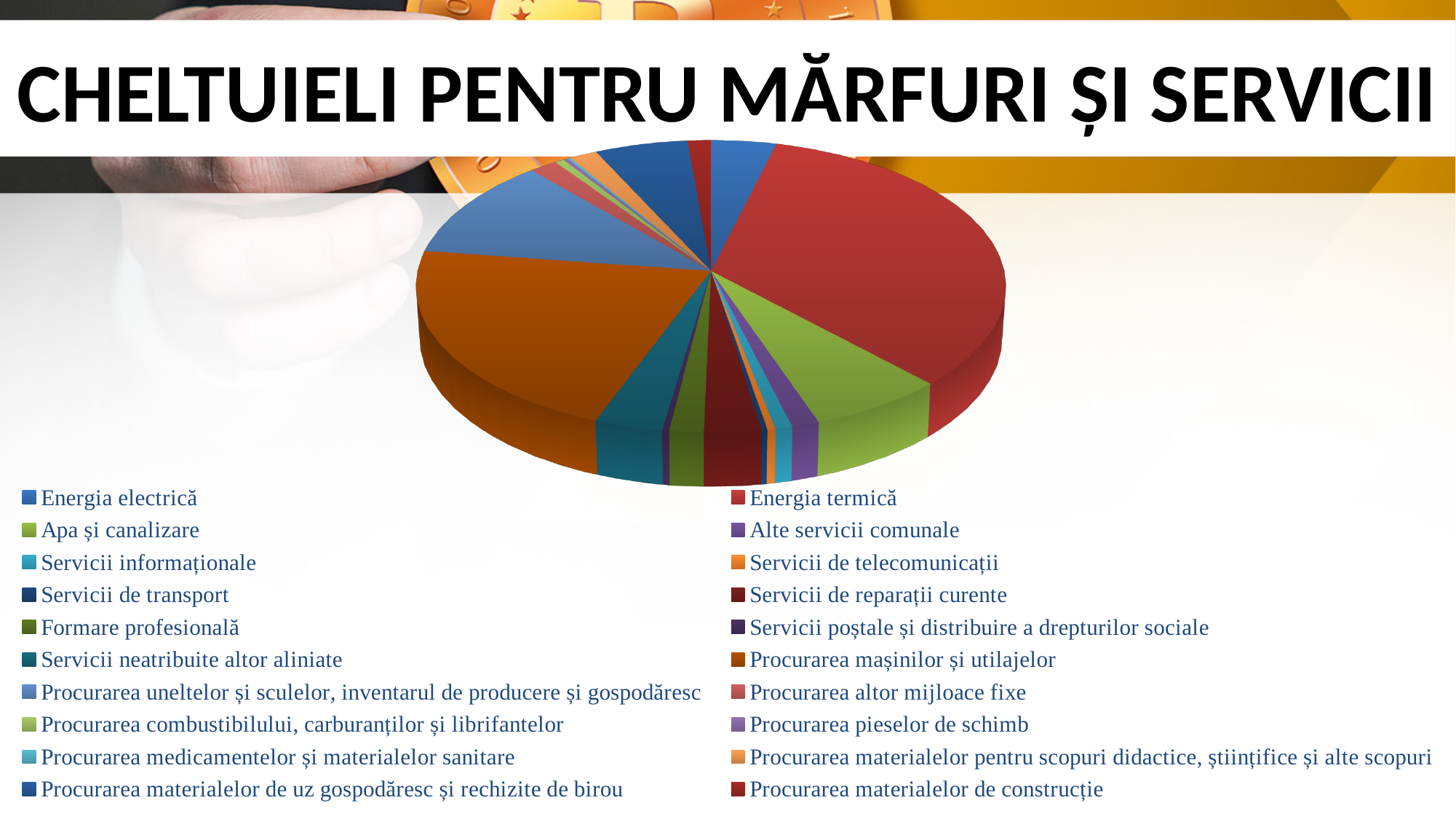
What is the title of the slide containing the pie chart? CHELTUIELI PENTRU MĂRFURI ȘI SERVICII Which slice is larger: Procurarea mașinilor și utilajelor or Apa și canalizare? Procurarea mașinilor și utilajelor Which slice is larger: Apa și canalizare or Formare profesională? Apa și canalizare Which category has the largest slice in the pie chart? Energia termică What kind of chart is shown on the slide? pie chart Which slice is larger: Energia termică or Procurarea mașinilor și utilajelor? Energia termică How many categories does the legend of the pie chart list? 20 What colour is the Energia termică slice in the pie chart? red